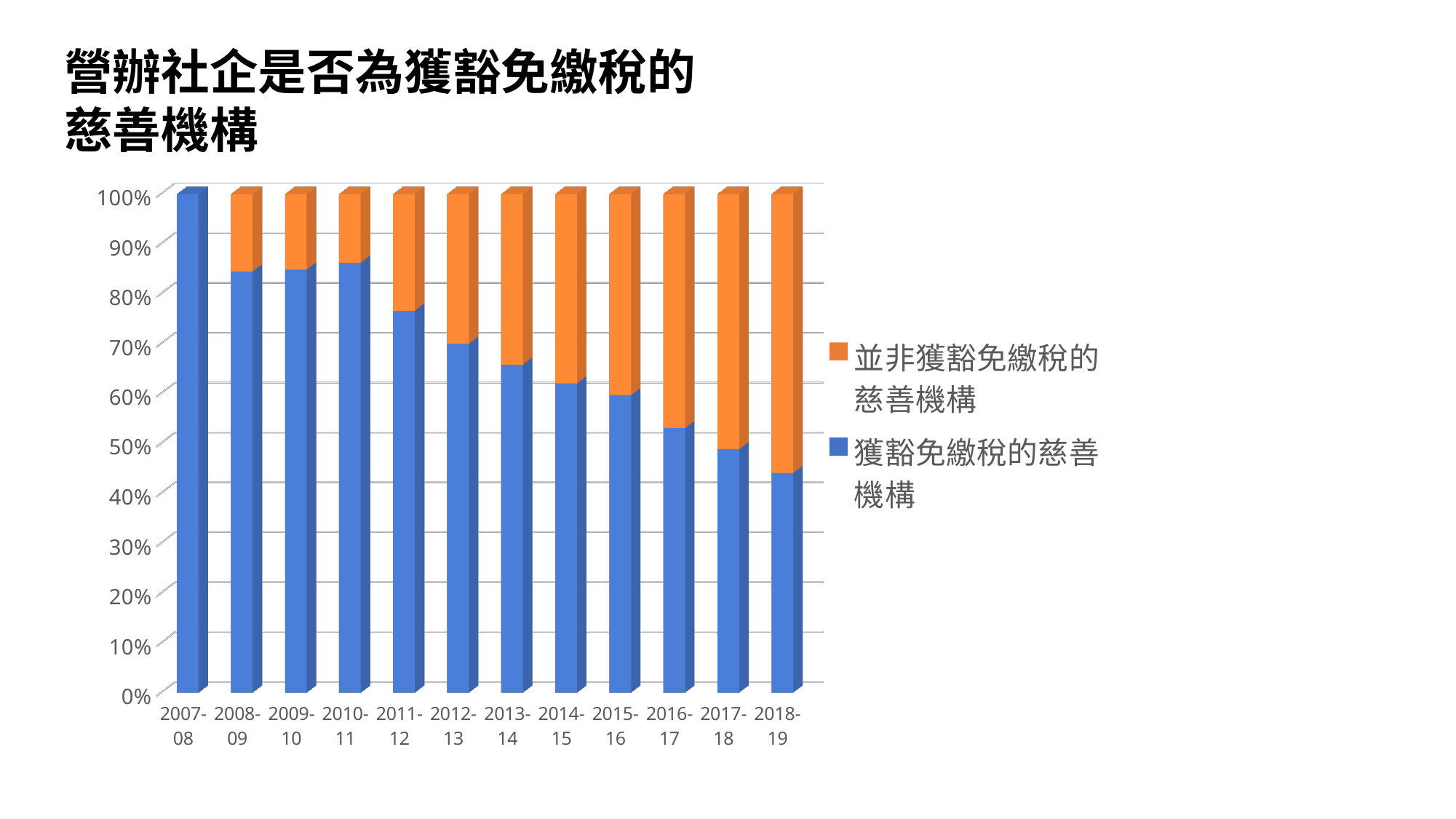
How many series does the legend list? 2 Which year has the lowest share of 獲豁免繳稅的慈善機構? 2018-19 How many year categories are shown on the x axis? 12 Does the share of 獲豁免繳稅的慈善機構 generally rise or fall from 2007-08 to 2018-19? fall Is the share of 獲豁免繳稅的慈善機構 in 2013-14 greater or less than 70%? less What kind of chart is shown on the slide? Stacked bar chart Is the share of 獲豁免繳稅的慈善機構 in 2018-19 greater or less than 50%? less Is the share of 獲豁免繳稅的慈善機構 in 2011-12 greater or less than 70%? greater Which year has the highest share of 獲豁免繳稅的慈善機構? 2007-08 Which year has a larger share of 獲豁免繳稅的慈善機構, 2008-09 or 2016-17? 2008-09 What is the value for 獲豁免繳稅的慈善機構 in 2007-08? 100% Which year has the largest share of 並非獲豁免繳稅的慈善機構? 2018-19